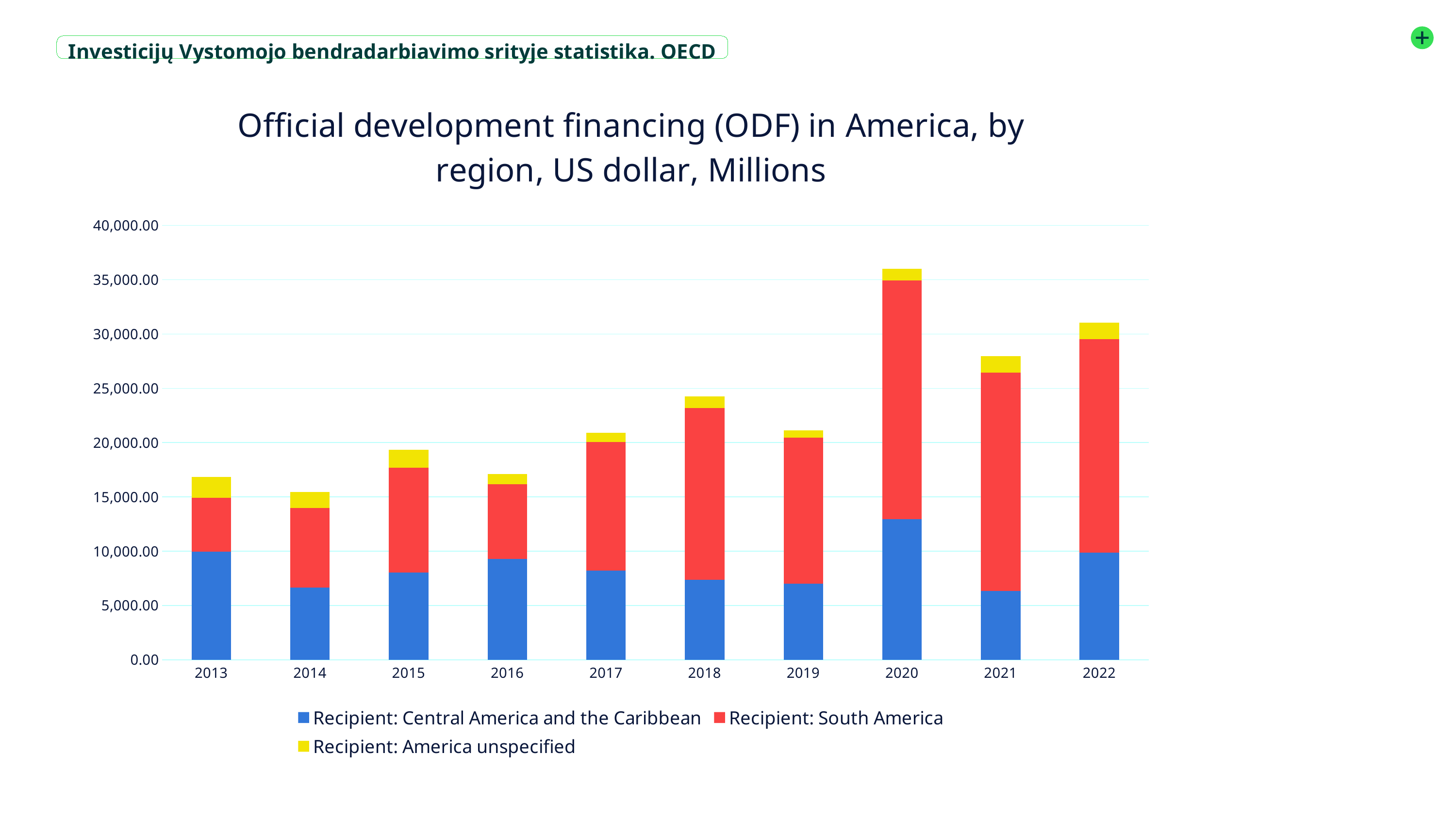
What kind of chart is shown on the slide? Stacked bar chart Which colour represents Recipient: South America in the chart? Red Which year has the highest total official development financing? 2020 Is the value for Recipient: Central America and the Caribbean in 2020 greater or less than 10,000.00? greater Is the value for Recipient: Central America and the Caribbean in 2014 greater or less than 10,000.00? less Which year has the lowest total official development financing? 2014 How many series does the legend list? 3 In which year is the value for Recipient: Central America and the Caribbean highest? 2020 Which year has a larger total, 2021 or 2022? 2022 Is the total value for 2021 greater or less than 30,000.00? less How many years are shown on the x axis? 10